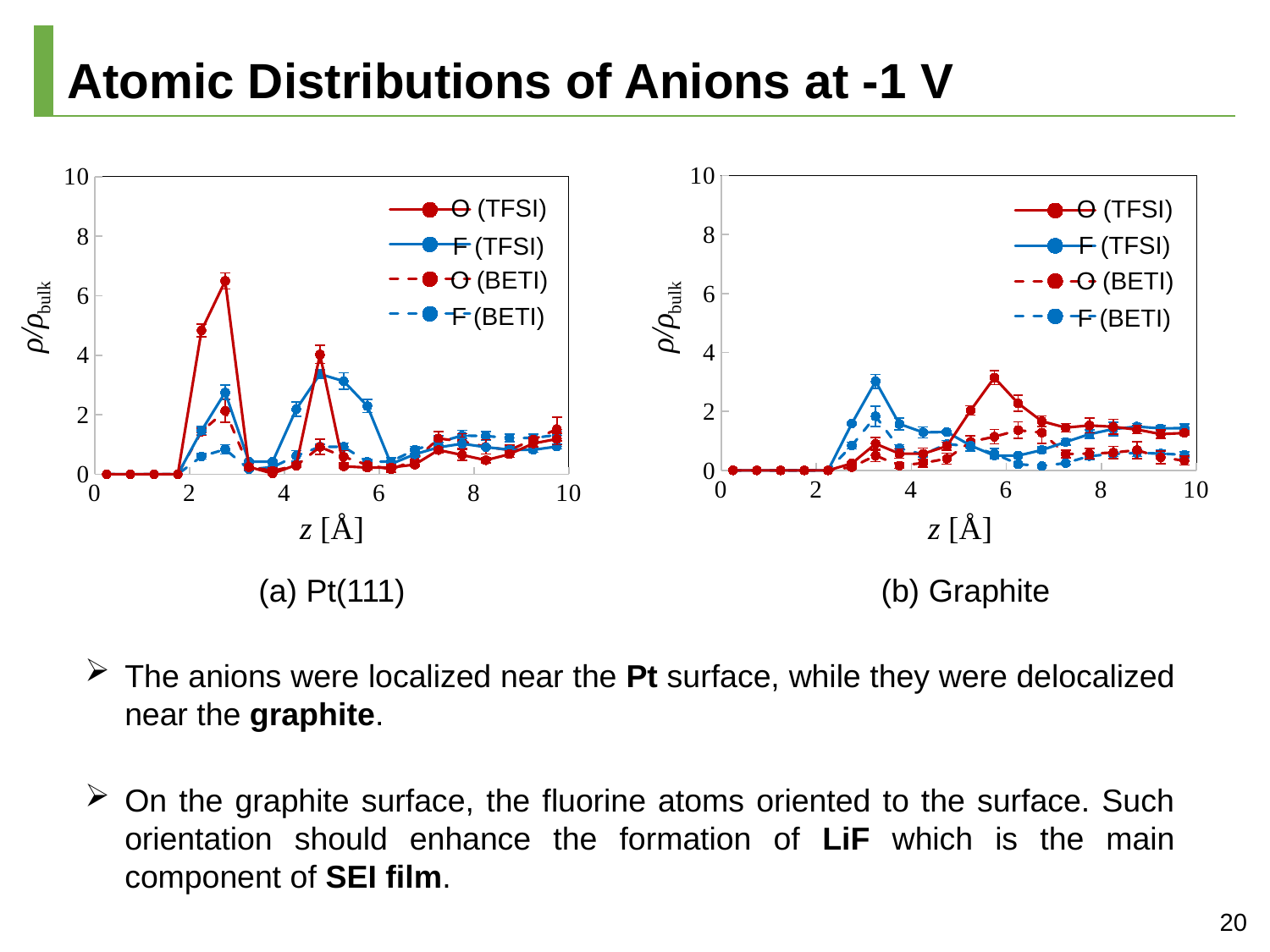
How many series does the legend of the (b) Graphite chart list? 4 In the (a) Pt(111) chart, is the peak value of F (TFSI) near z = 3 greater or less than 4? less In the (b) Graphite chart, what value do all series have at z = 1? 0 In the (a) Pt(111) chart, which series reaches the highest value? O (TFSI) In the (b) Graphite chart, what line style is used for the BETI series? dashed In the (b) Graphite chart, is the peak value of O (TFSI) greater or less than 4? less In the (a) Pt(111) chart, is the peak value of O (TFSI) greater or less than 6? greater In the (a) Pt(111) chart, which has the higher peak, O (TFSI) or O (BETI)? O (TFSI) What kind of chart is the (a) Pt(111) chart? line chart What is the x-axis label of the (a) Pt(111) chart? z [Å] In the (b) Graphite chart, near z = 3, which series is larger, F (TFSI) or O (TFSI)? F (TFSI)